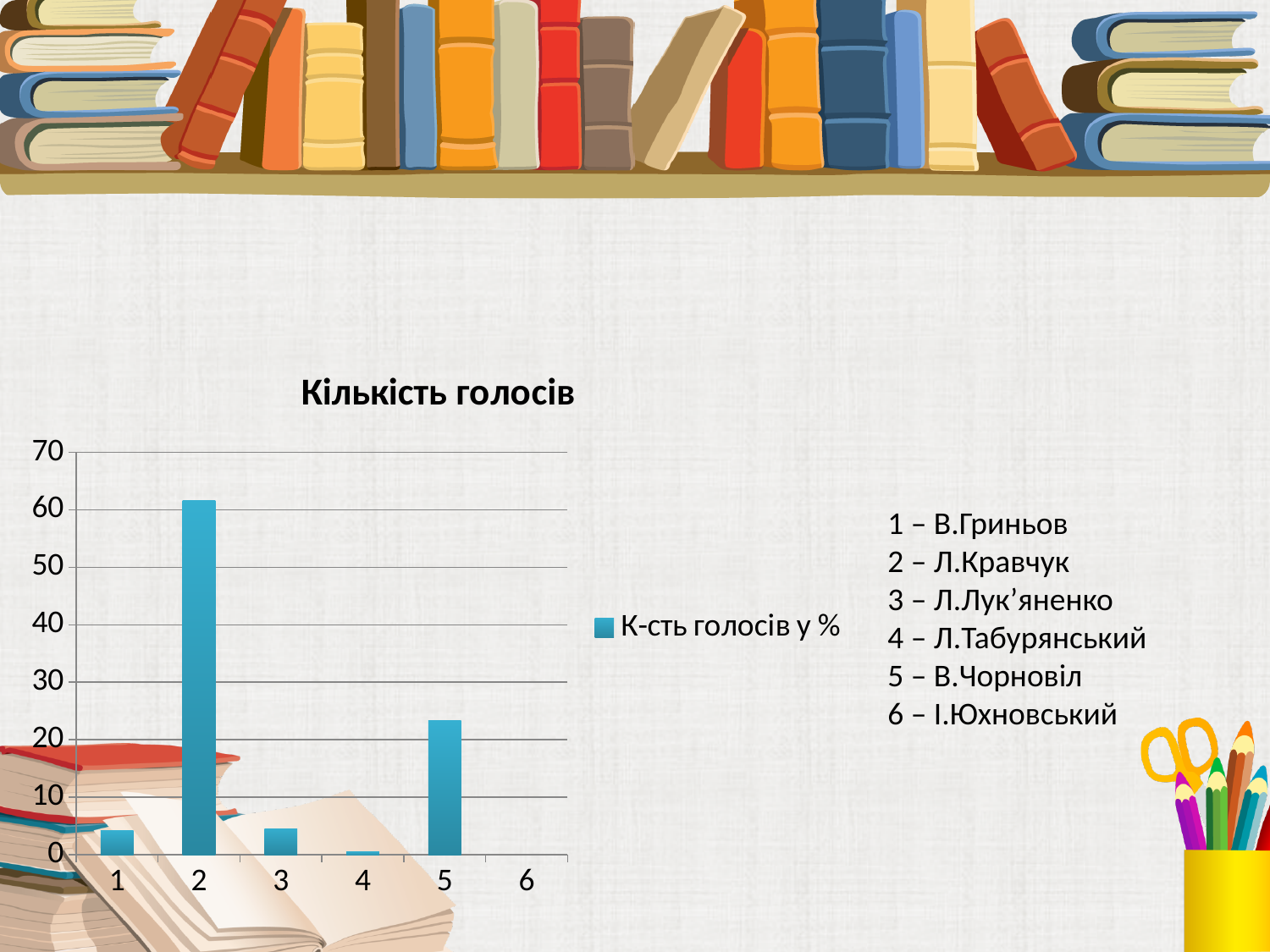
What kind of chart is shown on the slide? bar chart Which category has the highest value in the chart? 2 How many categories are shown on the x axis of the chart? 6 Is the value for category 1 greater or less than 10? less How many series does the chart legend list? 1 Which has the larger value, category 5 or category 3? 5 Which has the larger value, category 2 or category 5? 2 What is the title of the chart? Кількість голосів What is the legend entry for the series in the chart? К-сть голосів у % Is the value for category 5 greater or less than 30? less Is the value for category 2 greater or less than 50? greater